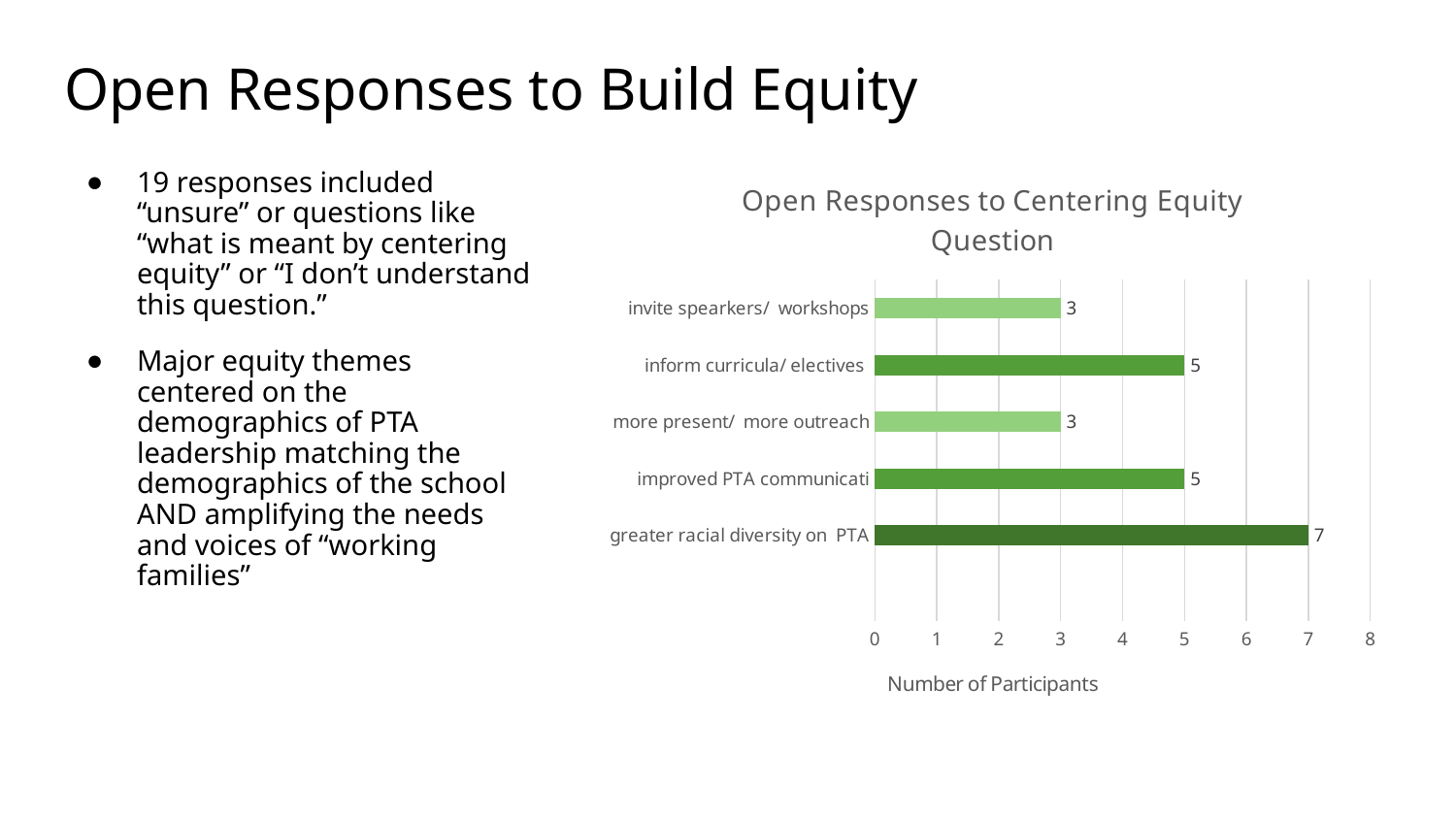
What is the difference between "inform curricula/ electives" and "invite spearkers/ workshops"? 2 What kind of chart is shown on the slide? bar chart What is the value for "inform curricula/ electives"? 5 What is the title of the chart? Open Responses to Centering Equity Question What is the value for "invite spearkers/ workshops"? 3 How many categories are shown in the chart? 5 Which category has the highest number of participants? greater racial diversity on PTA Which is larger: "inform curricula/ electives" or "more present/ more outreach"? inform curricula/ electives What is the value for "greater racial diversity on PTA"? 7 Is the value for "greater racial diversity on PTA" greater or less than 6? greater What is the label of the horizontal axis? Number of Participants What is the difference between "greater racial diversity on PTA" and "improved PTA communicati"? 2